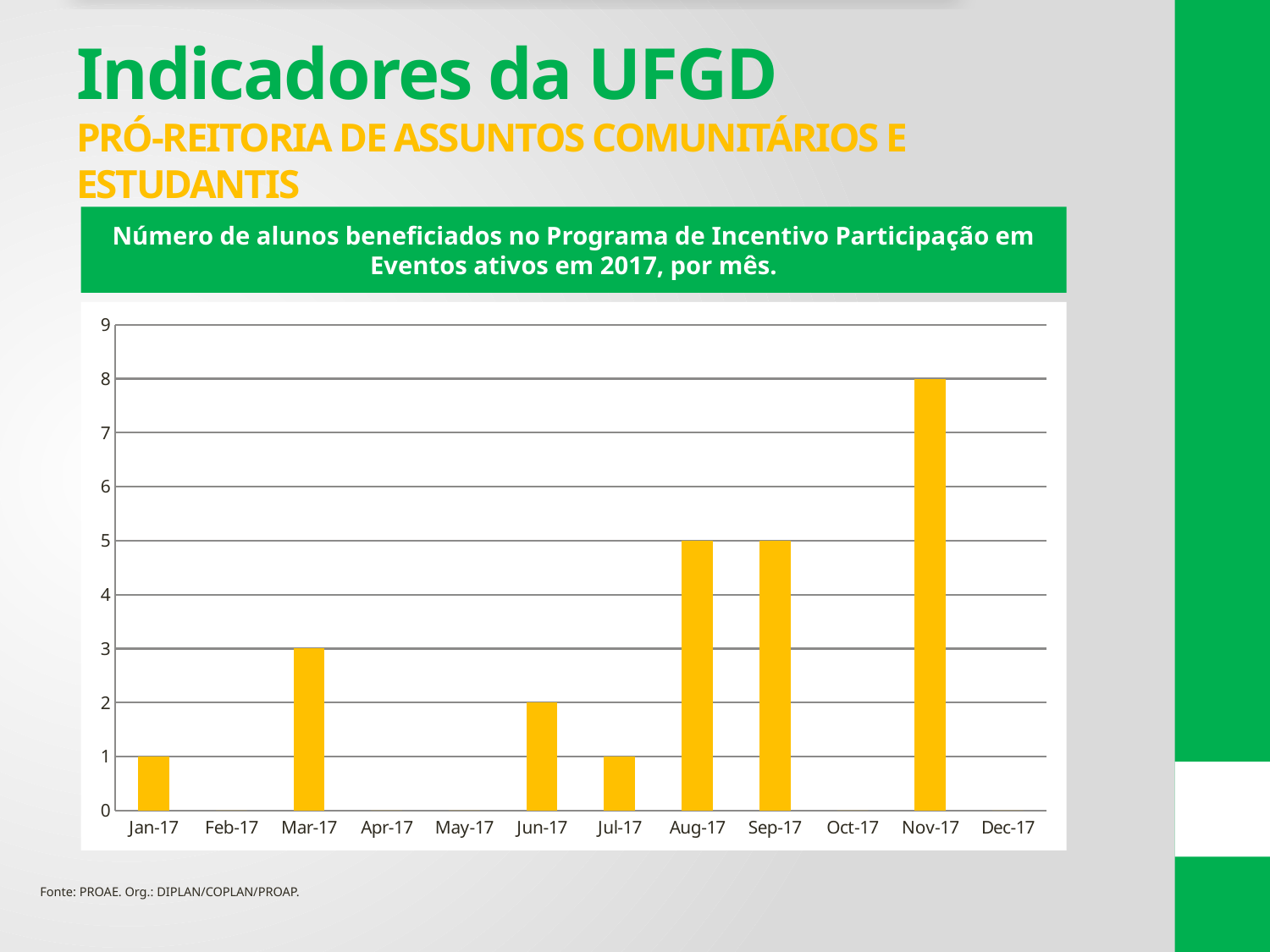
Is the value for Nov-17 greater or less than 7? greater What is the difference between the values for Nov-17 and Sep-17? 3 What is the value for Nov-17? 8 What is the value for Mar-17? 3 Which is larger, the value for Mar-17 or the value for Jul-17? Mar-17 Which month has the highest number of students benefited? Nov-17 What kind of chart is shown on the slide? bar chart How many months have a bar with a value greater than zero? 7 What is the title of the chart? Número de alunos beneficiados no Programa de Incentivo Participação em Eventos ativos em 2017, por mês. What is the value for Jun-17? 2 How many months are shown on the x axis of the chart? 12 What is the value for Aug-17? 5